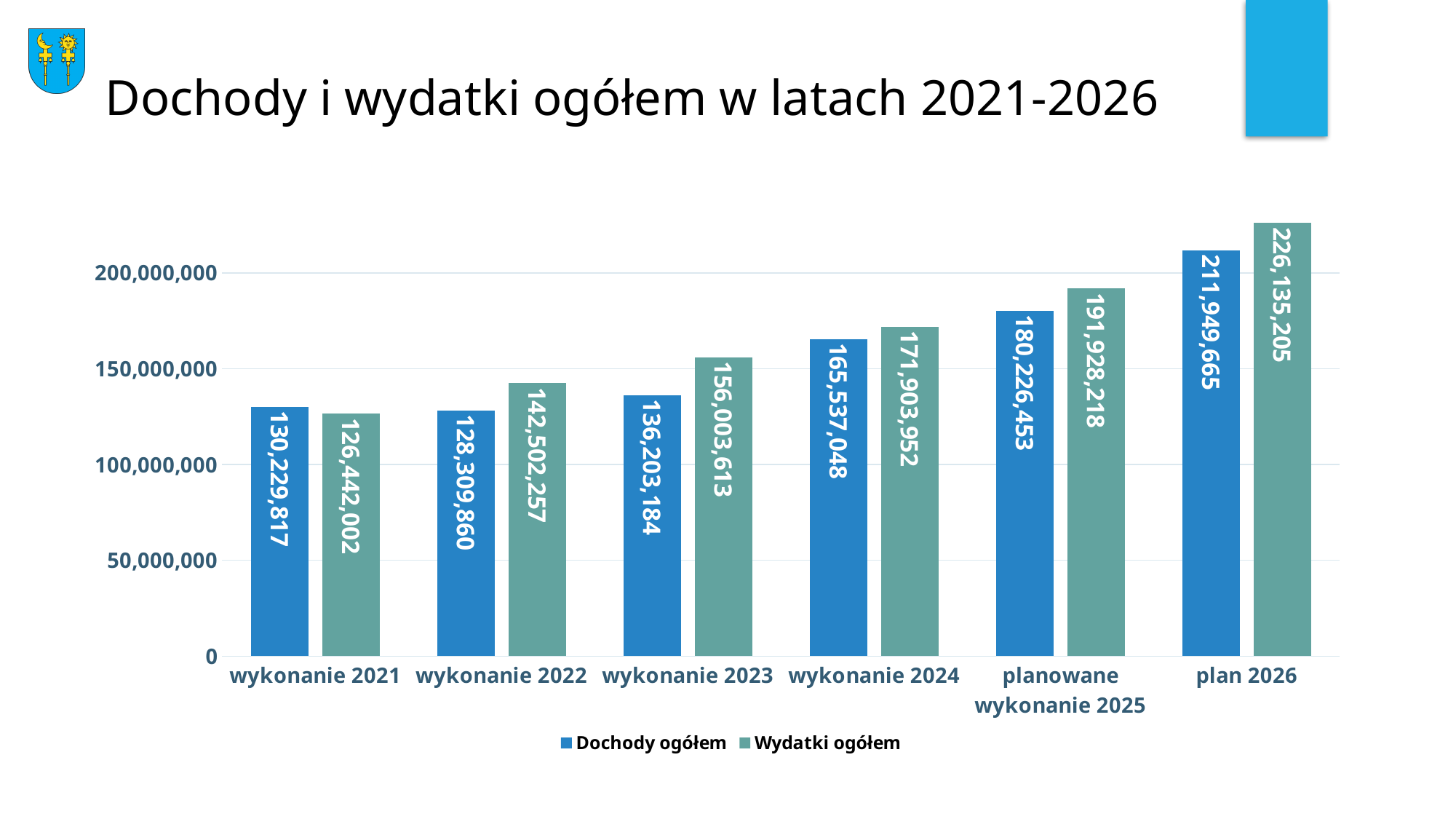
What is the difference between Wydatki ogółem and Dochody ogółem for wykonanie 2022? 14,192,397 What is the value of Wydatki ogółem for wykonanie 2023? 156,003,613 How many series does the legend list? 2 How many categories are shown on the x axis? 6 Which is larger for wykonanie 2021: Dochody ogółem or Wydatki ogółem? Dochody ogółem Which category has the lowest value of Dochody ogółem? wykonanie 2022 What is the value of Dochody ogółem for planowane wykonanie 2025? 180,226,453 What kind of chart is shown on the slide? bar chart Which category has the highest value of Wydatki ogółem? plan 2026 What is the difference between Wydatki ogółem and Dochody ogółem for plan 2026? 14,185,540 What is the value of Wydatki ogółem for plan 2026? 226,135,205 What is the value of Dochody ogółem for wykonanie 2021? 130,229,817